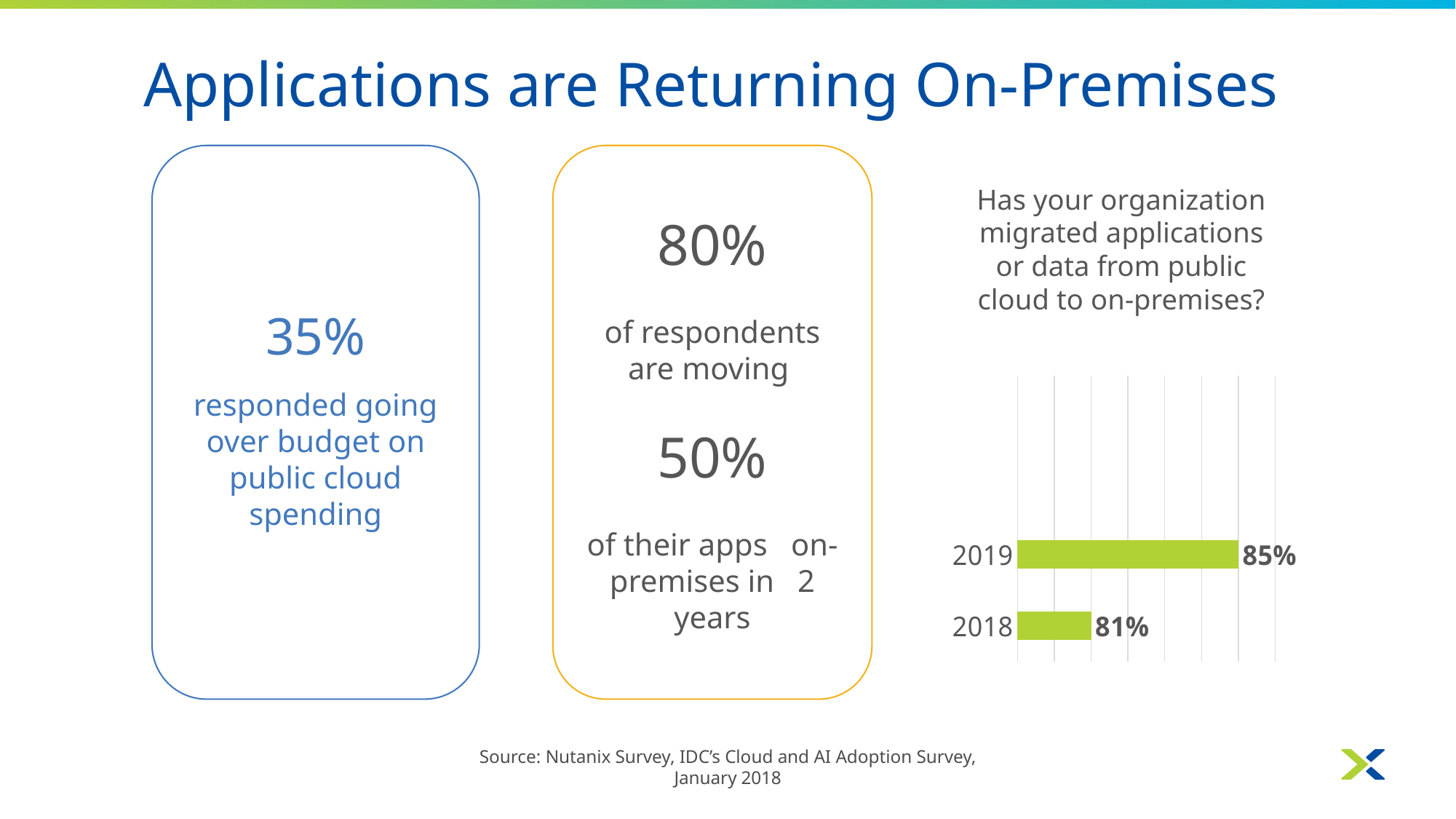
What kind of chart is shown on the slide? bar chart Which year has the higher value in the chart? 2019 Which year has the lower value in the chart? 2018 What is the value for 2018 in the chart? 81% What colour are the bars in the chart? green What is the value for 2019 in the chart? 85% Is the value for 2019 larger or smaller than the value for 2018? larger What is the difference between the 2019 and 2018 values in the chart? 4% What question does the chart's title ask? Has your organization migrated applications or data from public cloud to on-premises? Did the value rise or fall from 2018 to 2019? rise How many categories (years) are shown in the chart? 2